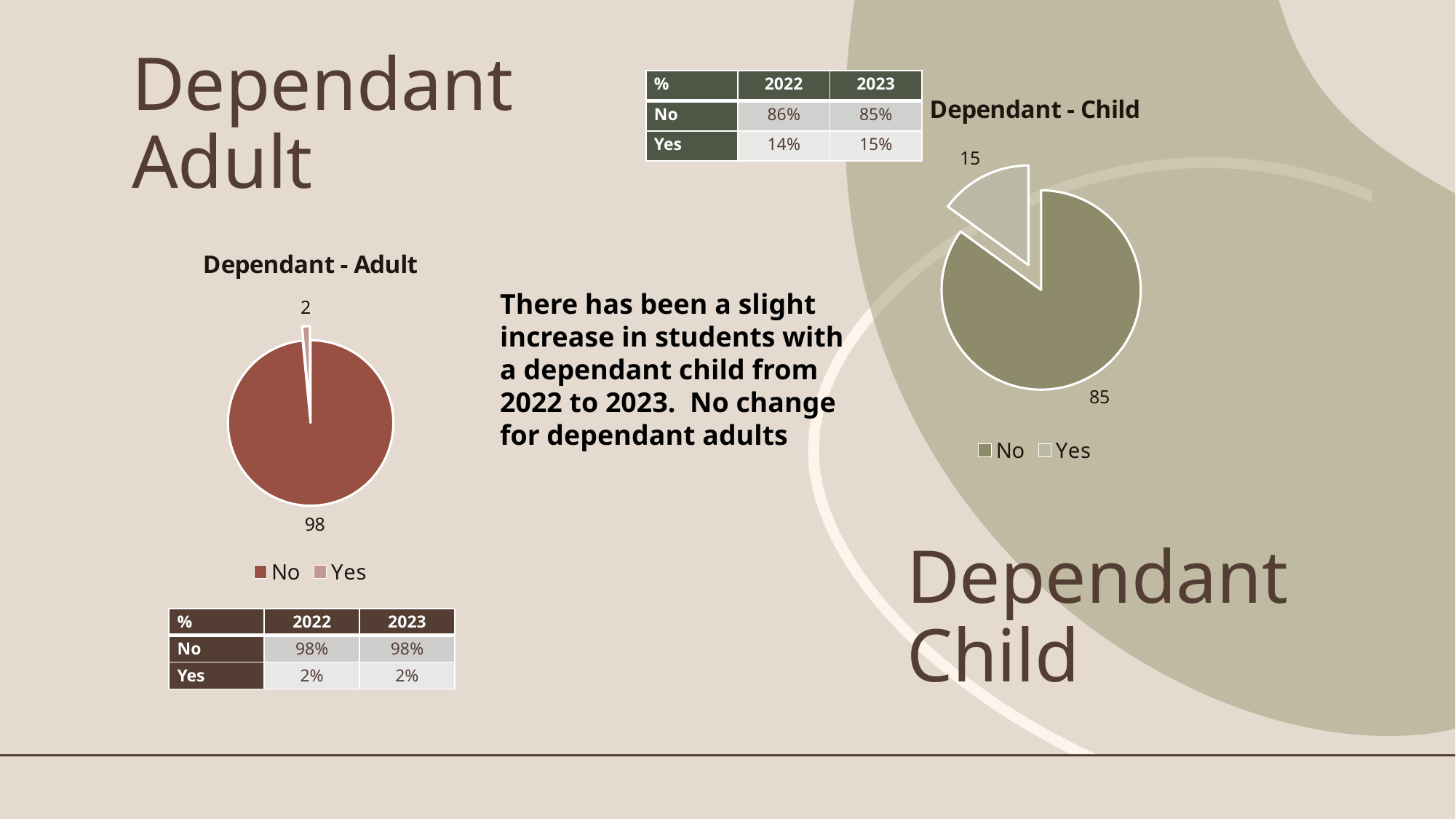
What entries does the legend of the 'Dependant - Child' chart list? No, Yes In the 'Dependant - Child' chart, what is the value for Yes? 15 What kind of chart is the 'Dependant - Adult' chart? Pie chart In the 'Dependant - Child' chart, which category is the largest? No In the 'Dependant - Adult' chart, what is the value for Yes? 2 In the 'Dependant - Child' chart, what is the value for No? 85 In the 'Dependant - Adult' chart, which category is the smallest? Yes In the 'Dependant - Adult' chart, what is the difference between the No and Yes values? 96 In the 'Dependant - Adult' chart, what is the value for No? 98 Is the Yes value larger in the 'Dependant - Adult' chart or the 'Dependant - Child' chart? Dependant - Child How many slices does the 'Dependant - Child' chart have? 2 In the 'Dependant - Child' chart, what is the difference between the No and Yes values? 70